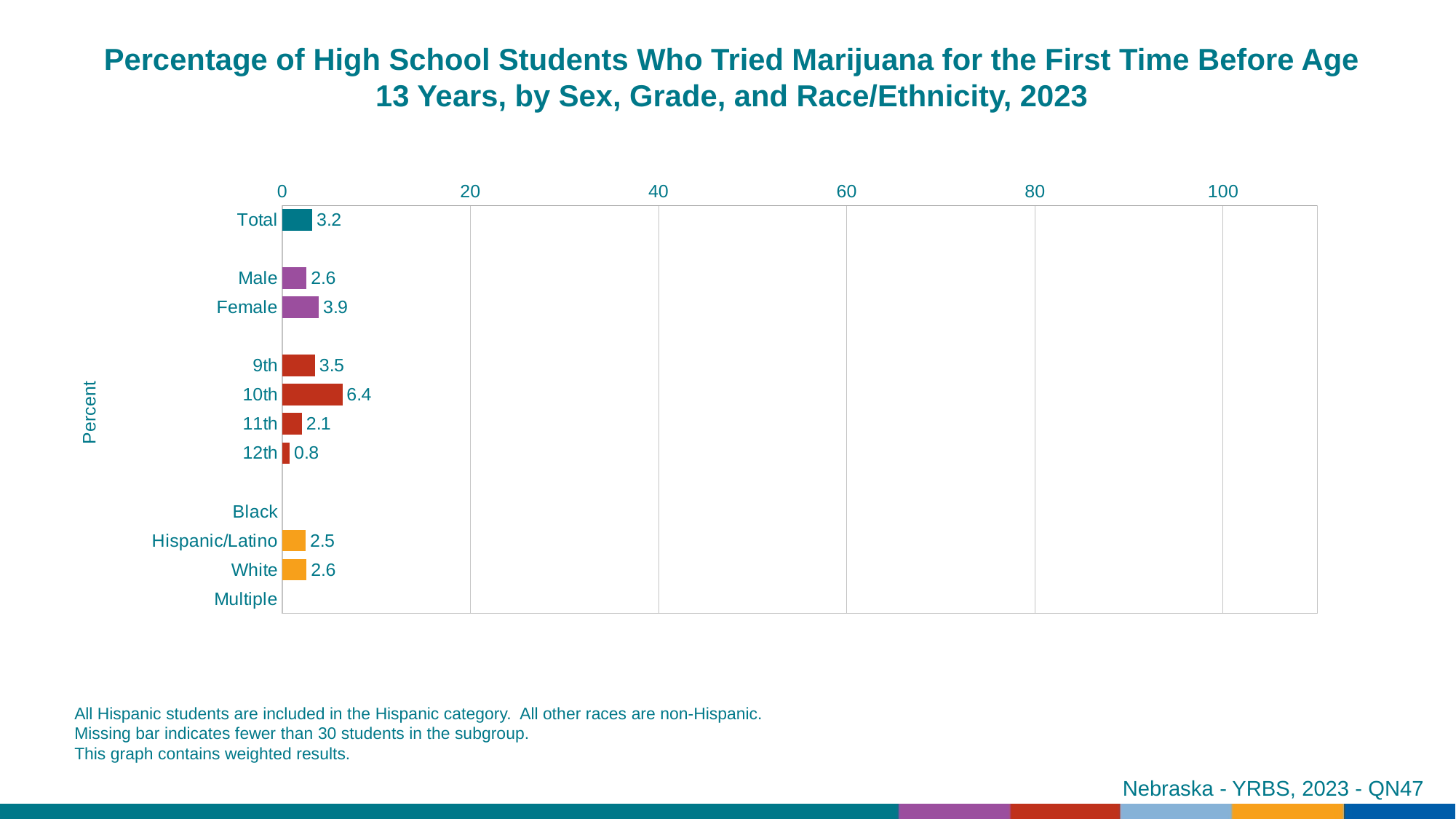
Is the value for 10th grade greater or less than 20? less Which categories have no bar shown? Black and Multiple What is the difference between the 10th and 11th grade values? 4.3 What is the value for 10th grade? 6.4 Which is larger, the value for 9th grade or the value for 12th grade? 9th What is the difference between the Female and Male values? 1.3 What kind of chart is shown on the slide? bar chart Which category has the highest value? 10th What is the value for Female? 3.9 What is the value for Hispanic/Latino? 2.5 What is the value for Total? 3.2 Which category with a bar has the lowest value? 12th